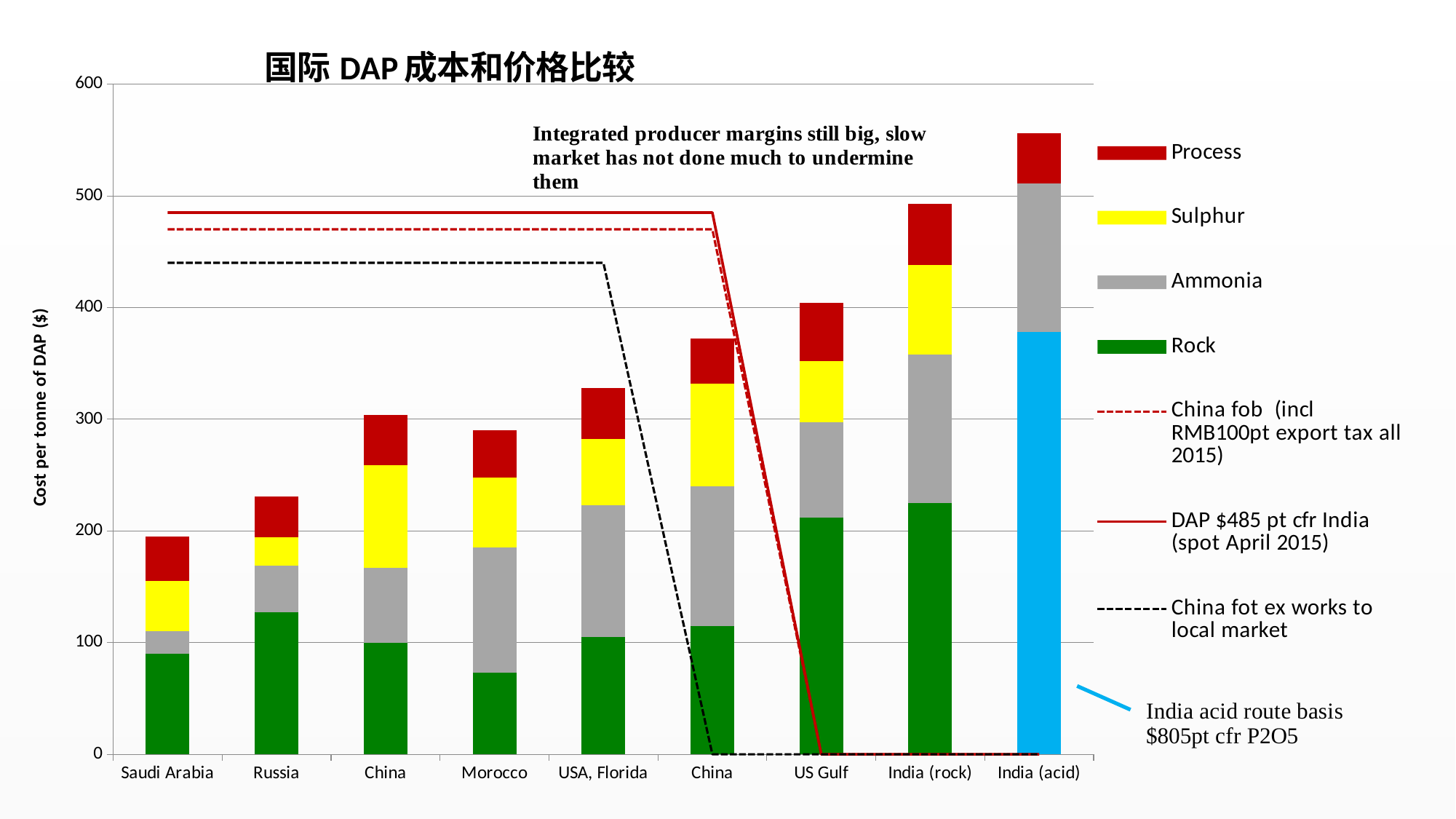
According to the legend, what is the DAP cfr India spot price (April 2015) shown by the solid red line? $485 Is the total bar height for Saudi Arabia greater or less than 200? less Which category has the shortest bar? Saudi Arabia Is the total bar height for India (acid) greater or less than 500? greater Which bar is taller, Russia or Morocco? Morocco Which colour represents Rock in the stacked bars? green What kind of chart is shown on the slide? combination stacked bar and line chart Is the total bar height for Morocco greater or less than 300? less How many categories are shown along the x axis? 9 How many entries does the legend list? 7 Which category has the tallest bar? India (acid)